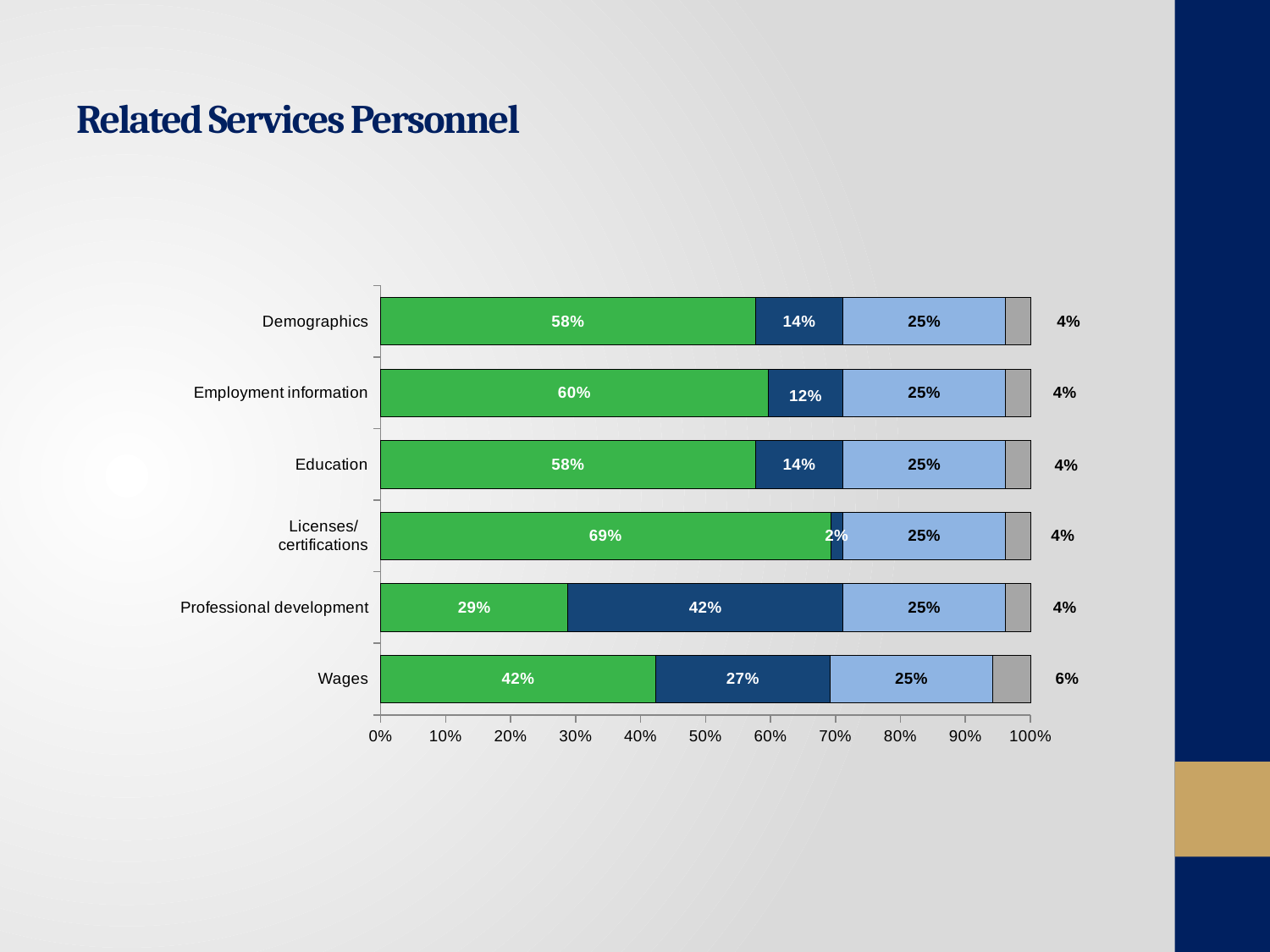
Which category has the smallest green segment? Professional development What is the value of the dark blue segment for Professional development? 42% What kind of chart is shown on the slide? Stacked bar chart Which category has the largest green segment? Licenses/certifications What is the difference between the green segment for Employment information and the green segment for Professional development? 31% Which is larger: the dark blue segment for Wages or the dark blue segment for Education? Wages What is the value of the dark blue segment for Employment information? 12% What is the title of the slide containing the chart? Related Services Personnel What is the value of the green segment for Licenses/certifications? 69% What is the value of the grey segment for Wages? 6% What is the value of the light blue segment for Demographics? 25% How many categories are plotted on the chart? 6